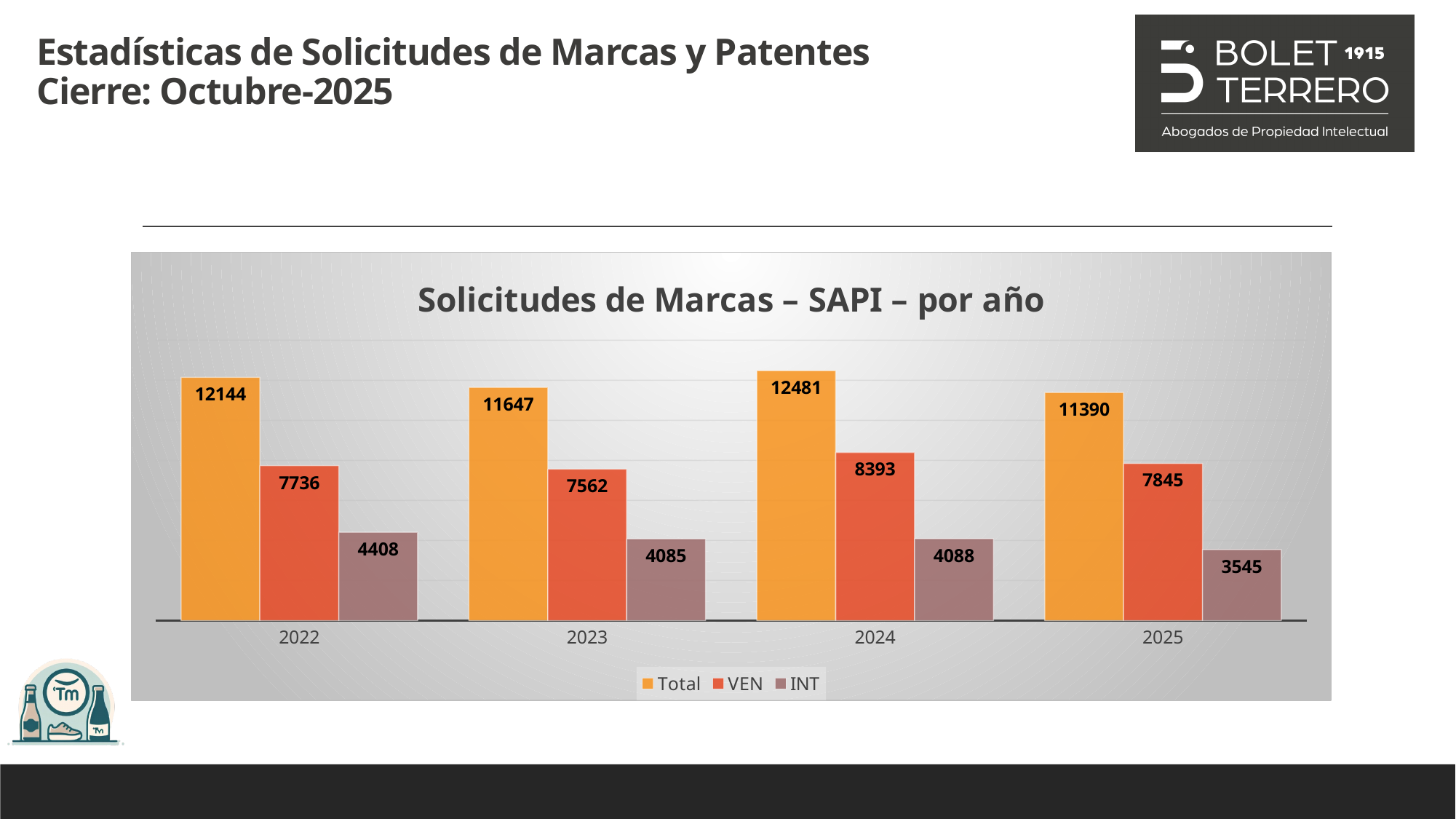
What is the INT value for 2025? 3545 Does the INT value rise or fall from 2024 to 2025? Fall What is the Total value for 2024? 12481 Which year has the highest Total value? 2024 What kind of chart is shown? Bar chart How many series does the legend list? 3 What is the VEN value for 2022? 7736 Which is larger, the Total value for 2022 or the Total value for 2023? 2022 How many years are shown on the x axis? 4 What is the difference between the VEN values for 2024 and 2023? 831 What is the title of the chart? Solicitudes de Marcas – SAPI – por año Which year has the lowest INT value? 2025